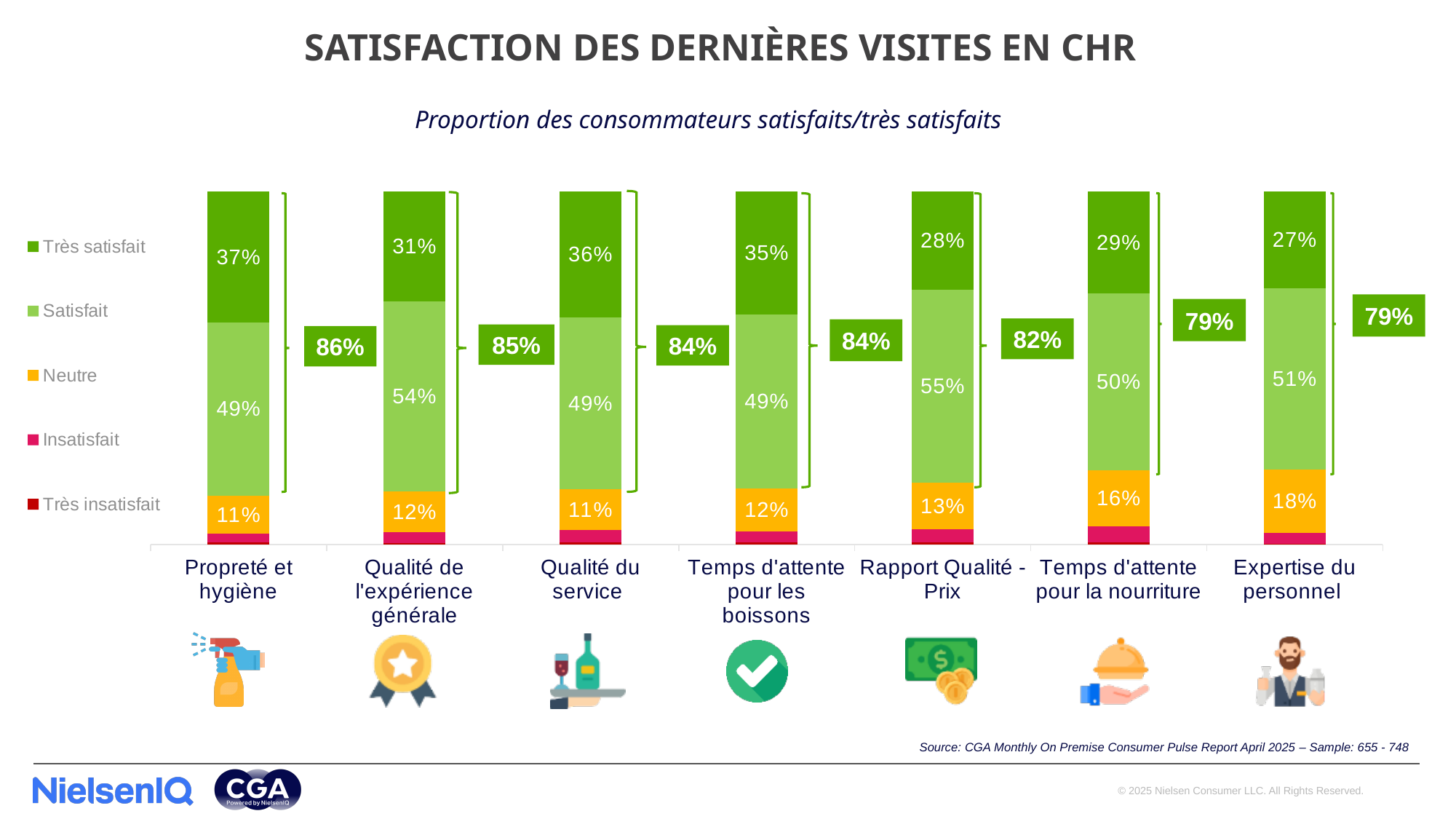
How many series does the legend list? 5 What is the 'Satisfait' value for 'Rapport Qualité - Prix'? 55% What is the 'Très satisfait' value for 'Propreté et hygiène'? 37% What is the difference between the 'Satisfait' values for 'Qualité de l'expérience générale' and 'Qualité du service'? 5% What kind of chart is shown on the slide? stacked bar chart How many categories are shown on the x axis? 7 What is the total of 'Très satisfait' and 'Satisfait' for 'Rapport Qualité - Prix'? 83% Which is larger: the 'Très satisfait' value for 'Temps d'attente pour les boissons' or for 'Temps d'attente pour la nourriture'? Temps d'attente pour les boissons Which category has the highest 'Très satisfait' value? Propreté et hygiène Which category has the lowest 'Neutre' value? Propreté et hygiène and Qualité du service (both 11%) What is the 'Neutre' value for 'Expertise du personnel'? 18% What is the combined satisfied/very satisfied proportion shown for 'Qualité de l'expérience générale'? 85%